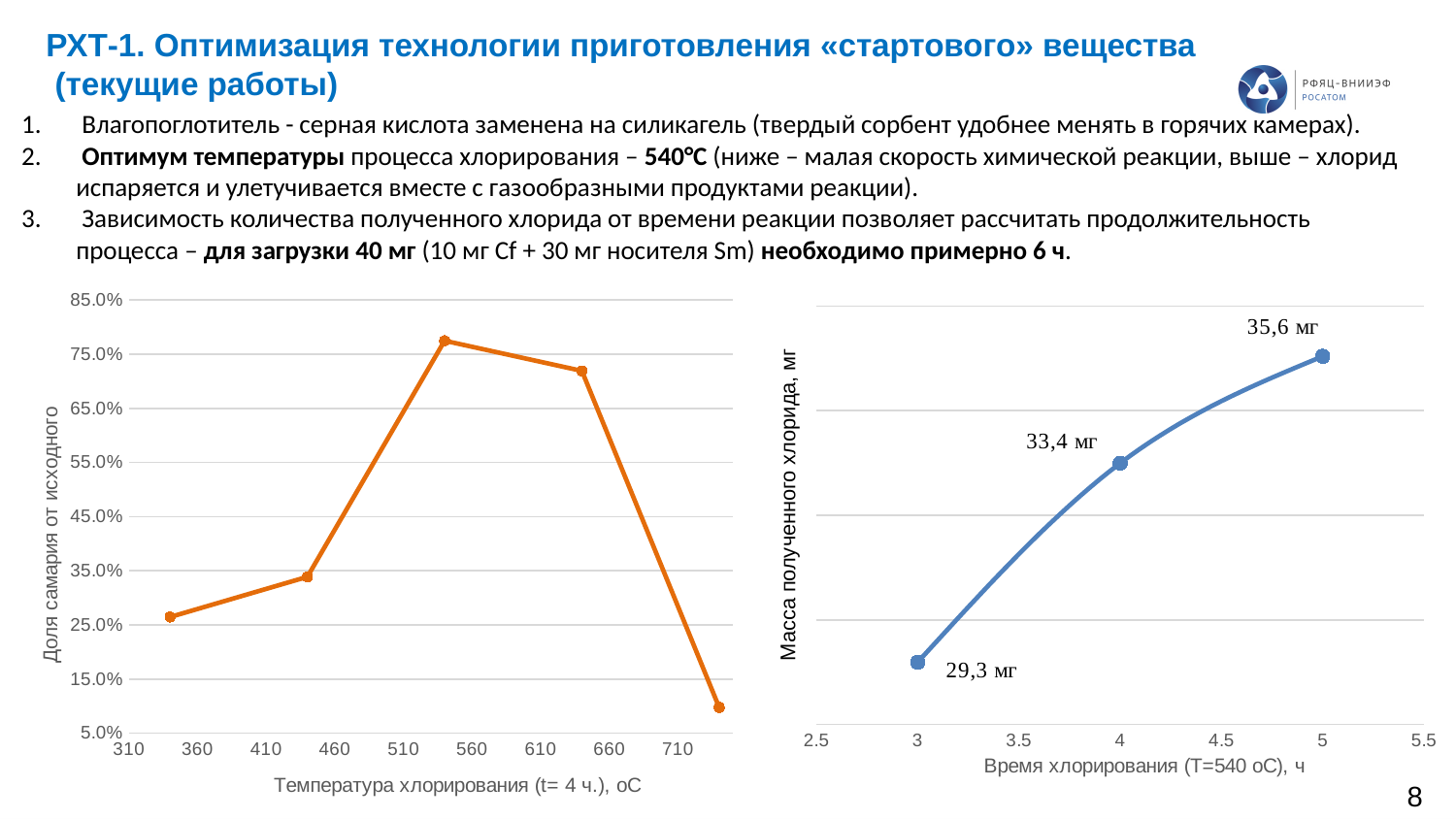
What kind of chart is the right chart (mass of chloride vs chlorination time)? line chart On the left chart (share of samarium vs chlorination temperature), is the highest plotted value greater or less than 65.0%? greater What kind of chart is the left chart (share of samarium vs chlorination temperature)? line chart On the right chart (mass of chloride vs chlorination time), what is the mass of chloride obtained after 3 hours? 29,3 мг On the right chart (mass of chloride vs chlorination time), does the mass of chloride rise or fall as chlorination time increases? rises On the right chart (mass of chloride vs chlorination time), what is the mass of chloride obtained after 5 hours? 35,6 мг On the right chart (mass of chloride vs chlorination time), how many data points are plotted? 3 What is the x-axis title of the left chart? Температура хлорирования (t= 4 ч.), оС On the left chart (share of samarium vs chlorination temperature), how many data points are plotted? 5 On the right chart (mass of chloride vs chlorination time), what is the mass of chloride obtained after 4 hours? 33,4 мг On the left chart (share of samarium vs chlorination temperature), is the value at the highest temperature (around 740 °C) greater or less than 15.0%? less On the right chart (mass of chloride vs chlorination time), by how much does the mass of chloride at 5 hours exceed the mass at 3 hours? 6,3 мг